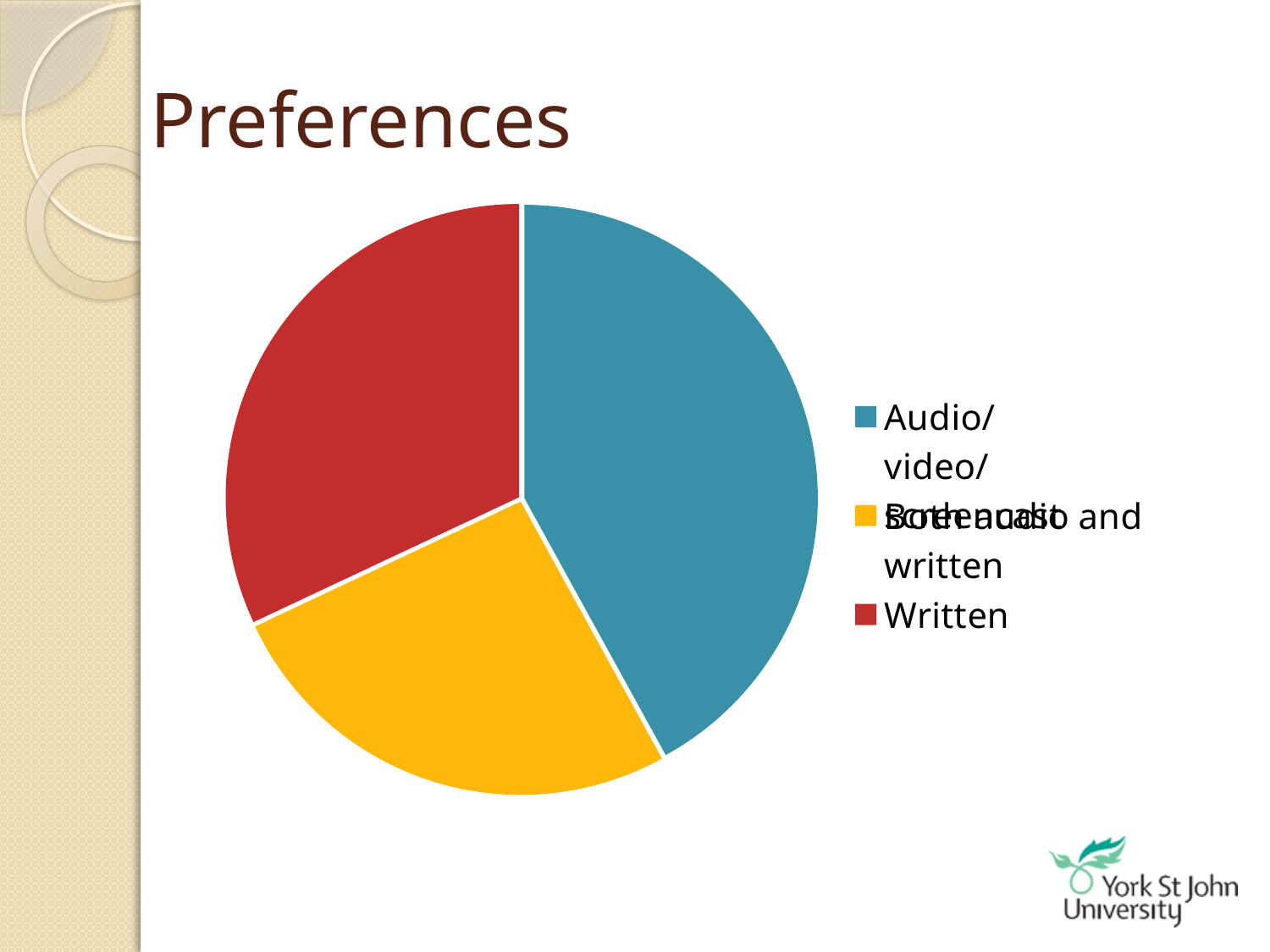
Which category has the smallest slice of the pie chart? Both audio and written Which slice is larger: Written or Audio/video/screencast? Audio/video/screencast Which category has the largest slice of the pie chart? Audio/video/screencast How many entries does the legend of the pie chart list? 3 What is the title of the slide containing the pie chart? Preferences How many slices does the pie chart have? 3 Which slice is larger: Written or Both audio and written? Written What kind of chart is shown on the slide? Pie chart What colour is the Written slice of the pie chart? Red